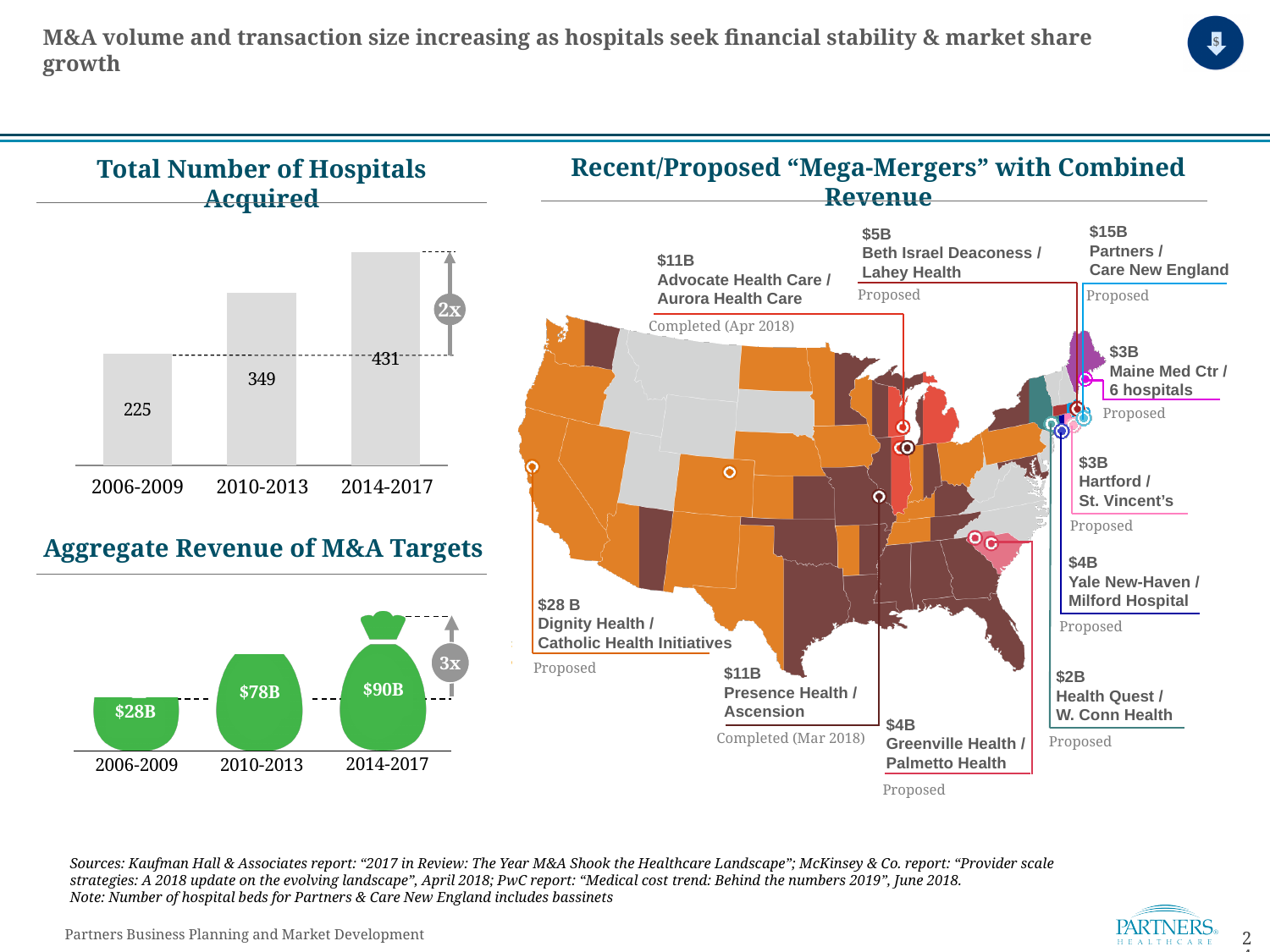
What kind of chart is "Total Number of Hospitals Acquired"? Bar chart In the "Total Number of Hospitals Acquired" chart, which period has the lowest number of hospitals acquired? 2006-2009 In the "Aggregate Revenue of M&A Targets" chart, what is the aggregate revenue for 2010-2013? $78B In the "Total Number of Hospitals Acquired" chart, how many hospitals were acquired in 2006-2009? 225 In the "Aggregate Revenue of M&A Targets" chart, what multiplier is shown next to the arrow on the right? 3x In the "Total Number of Hospitals Acquired" chart, which period has the highest number of hospitals acquired? 2014-2017 In the "Aggregate Revenue of M&A Targets" chart, what is the difference between the 2014-2017 value and the 2006-2009 value? $62B In the "Total Number of Hospitals Acquired" chart, do the values rise or fall from 2006-2009 to 2014-2017? Rise In the "Total Number of Hospitals Acquired" chart, how many hospitals were acquired in 2010-2013? 349 In the "Total Number of Hospitals Acquired" chart, how many hospitals were acquired in 2014-2017? 431 In the "Total Number of Hospitals Acquired" chart, what is the difference between the number of hospitals acquired in 2014-2017 and in 2006-2009? 206 In the "Total Number of Hospitals Acquired" chart, how many periods are shown on the x axis? 3